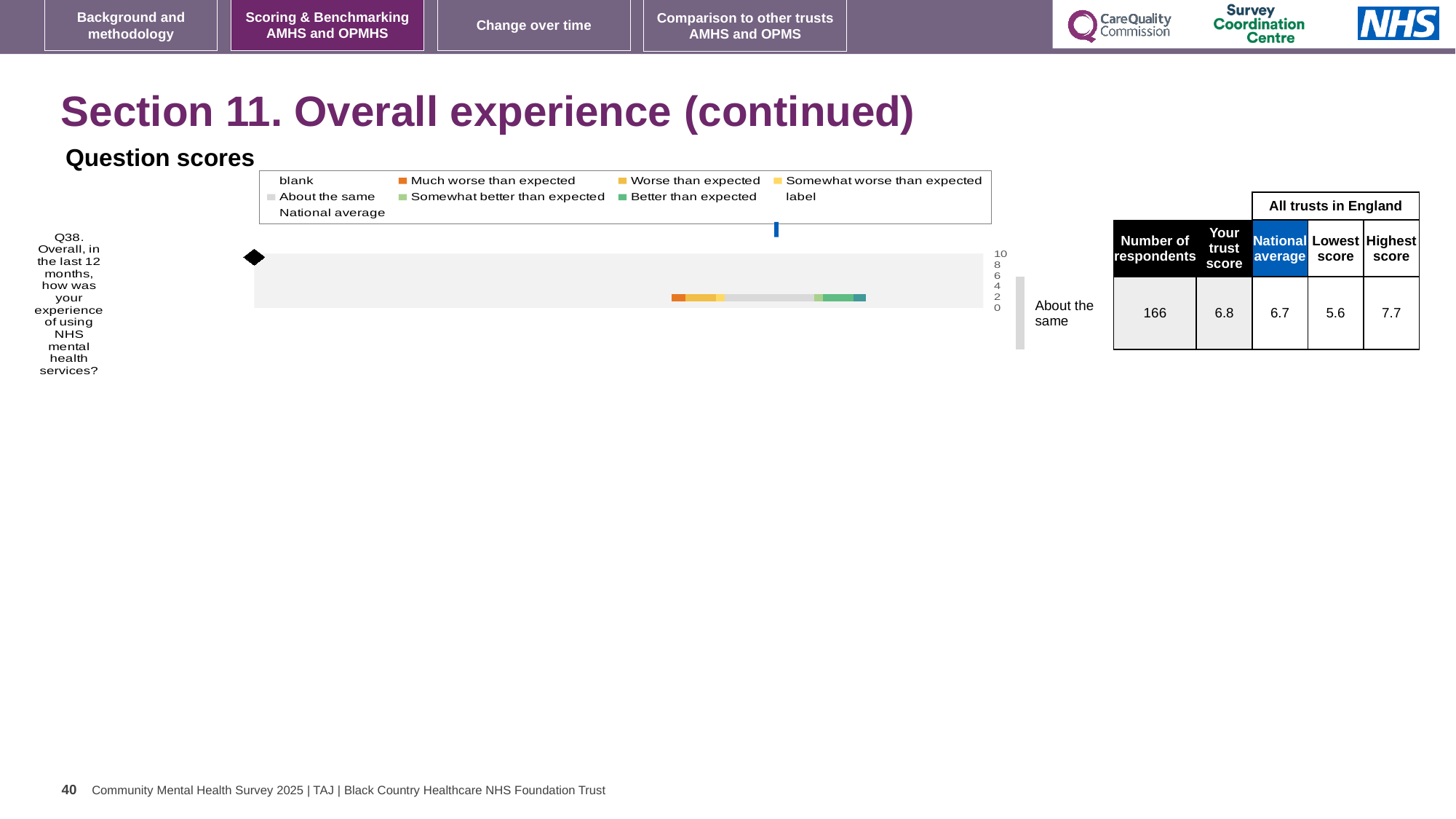
How many survey questions are plotted in the Question scores chart? 1 What is the trust's score for Q38 shown in the table beside the chart? 6.8 For Q38, what is the difference between the highest score and the lowest score among all trusts in England? 2.1 Which question number is plotted in the Question scores chart? Q38 How many respondents answered Q38 according to the table beside the chart? 166 What benchmark category label is shown next to the bar for Q38? About the same For Q38, which is larger: the trust's score or the national average? The trust's score What is the highest score among all trusts in England for Q38? 7.7 What kind of chart is used to show the Q38 question score? Bar chart What is the national average score for Q38 shown in the table beside the chart? 6.7 What is the lowest score among all trusts in England for Q38? 5.6 What colour does the legend use for 'Much worse than expected'? Orange